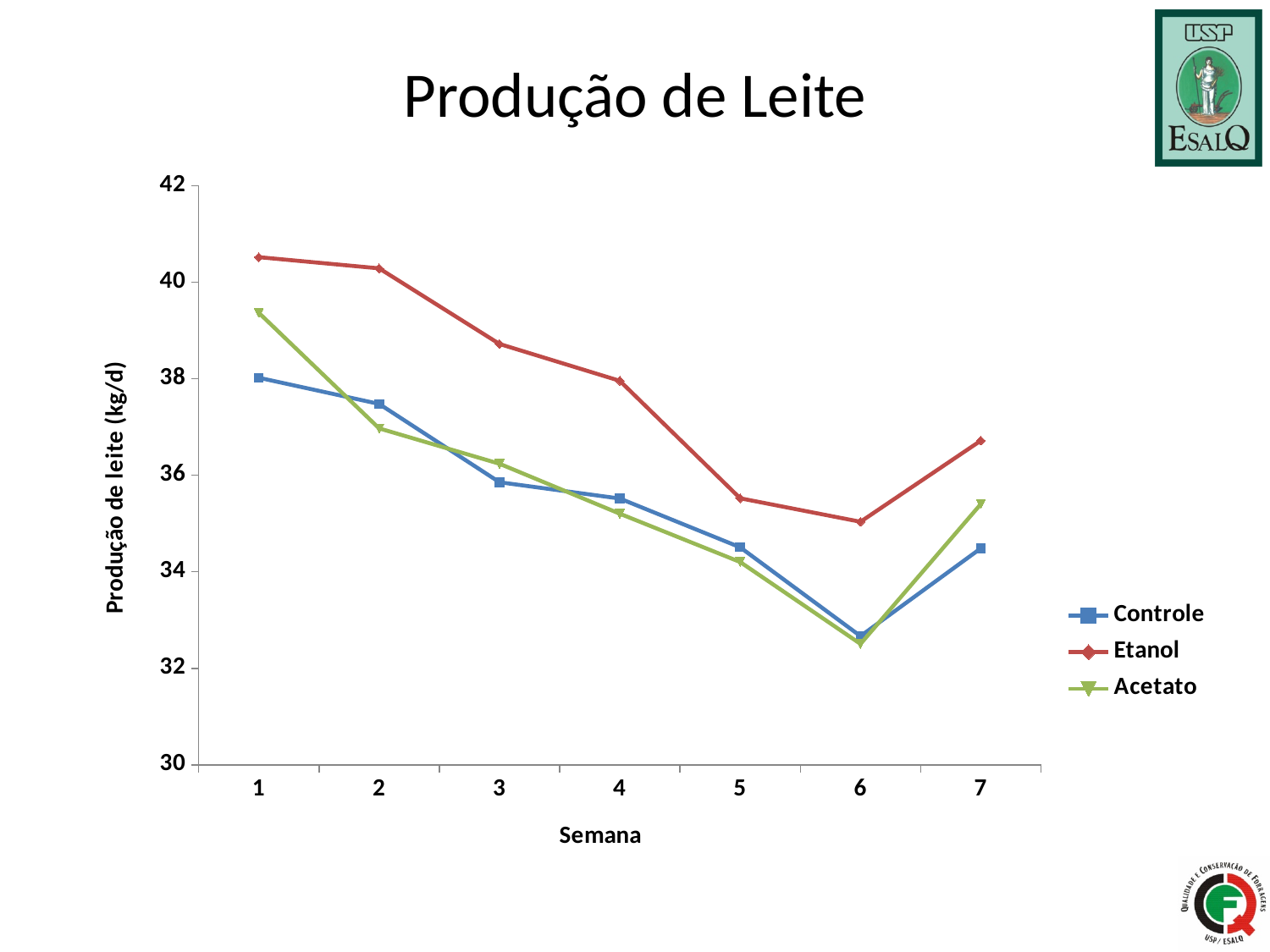
In which week does Etanol reach its lowest value? 6 How many series does the legend list? 3 In week 4, which is larger, Etanol or Controle? Etanol Is the value for Etanol in week 1 greater or less than 40? greater What kind of chart is shown on the slide? line chart How many weeks (Semana) are plotted on the x axis? 7 What is the label of the y axis? Produção de leite (kg/d) Do the Etanol values rise or fall from week 1 to week 6? fall Is the value for Acetato in week 6 greater or less than 32? greater Is the value for Etanol in week 6 greater or less than 34? greater Which series has the highest value in week 1? Etanol